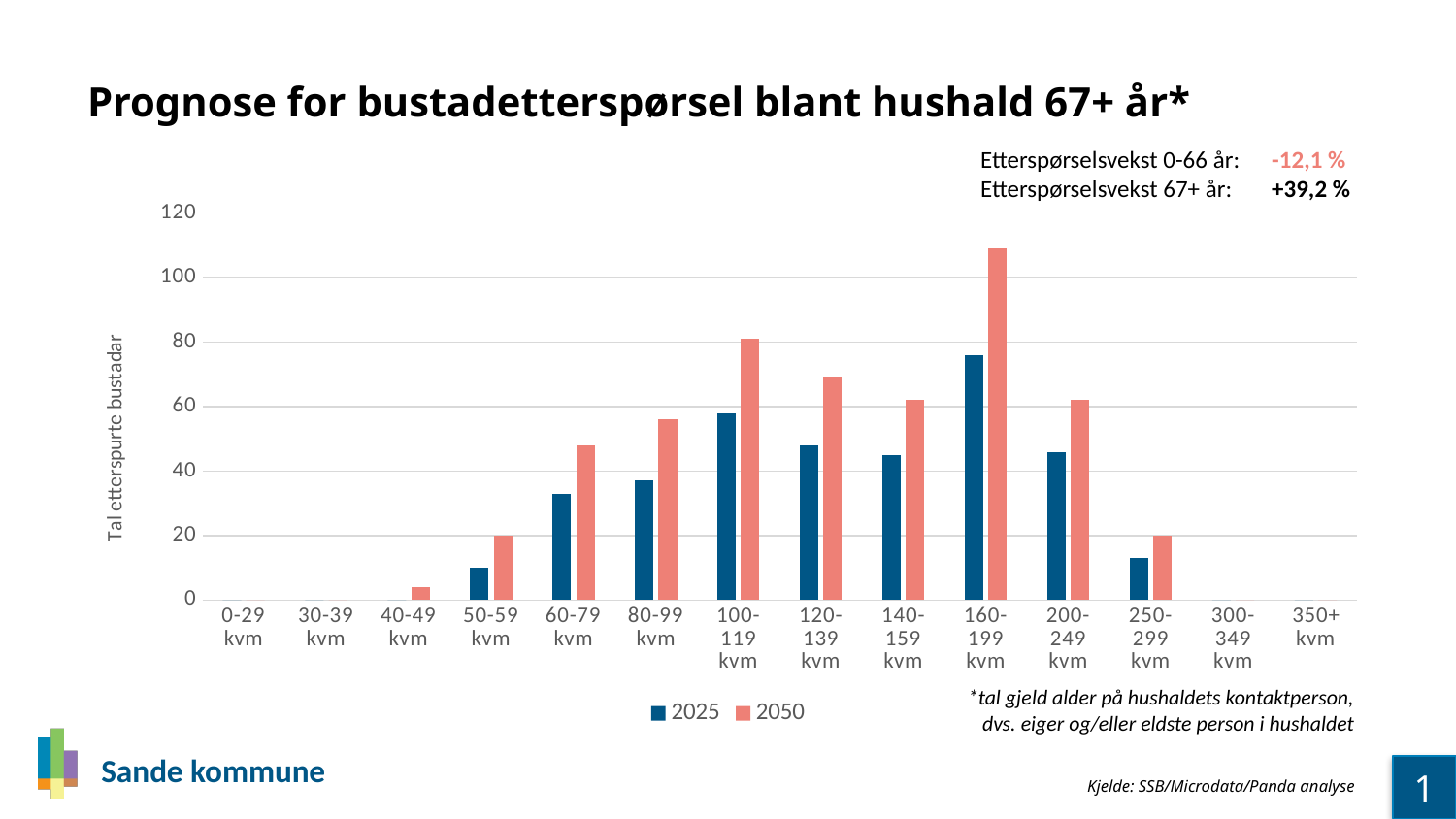
What is the title of the chart? Prognose for bustadetterspørsel blant hushald 67+ år* Which size category has the highest value for the 2025 series? 160-199 kvm How many size categories are shown on the x axis? 14 Which size category has the highest value for the 2050 series? 160-199 kvm Is the 2025 value for 60-79 kvm greater or less than 40? less What are the two entries in the chart legend? 2025 and 2050 How many series does the legend list? 2 Is the 2050 value for 160-199 kvm greater or less than 100? greater For 100-119 kvm, which series has the larger value, 2025 or 2050? 2050 What kind of chart is shown on the slide? bar chart Is the 2025 value for 250-299 kvm greater or less than 20? less